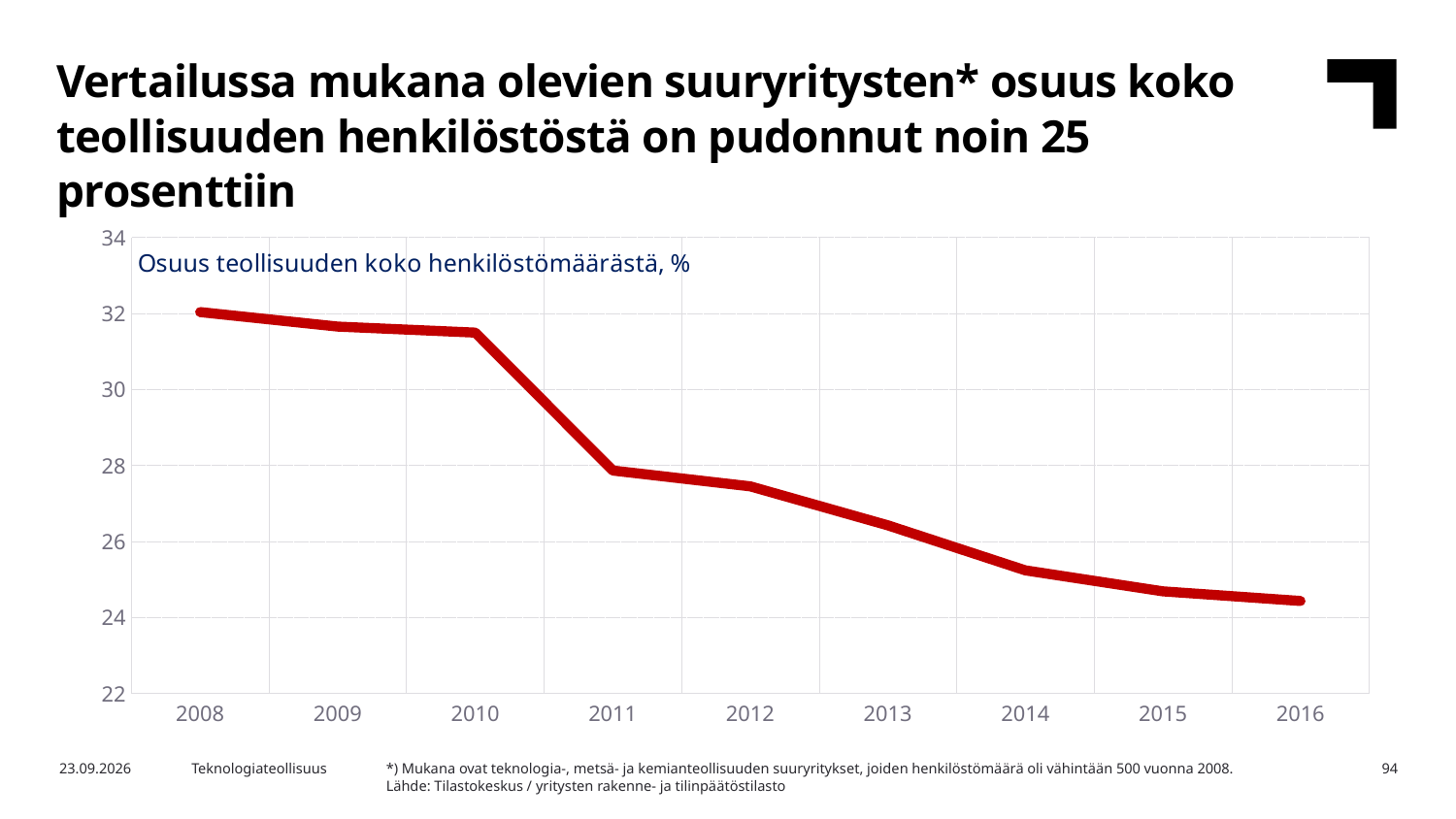
Is the value for 2016 greater or less than 24? greater Which year has the lowest value? 2016 Which year has the highest value? 2008 What label is printed inside the chart area describing the plotted series? Osuus teollisuuden koko henkilöstömäärästä, % Which is larger, the value for 2010 or the value for 2011? 2010 Is the value for 2011 greater or less than 30? less Is the value for 2014 greater or less than 26? less Do the values rise or fall from 2008 to 2016? fall What kind of chart is shown on the slide? line chart What colour is the plotted line? red How many years are plotted on the x axis? 9